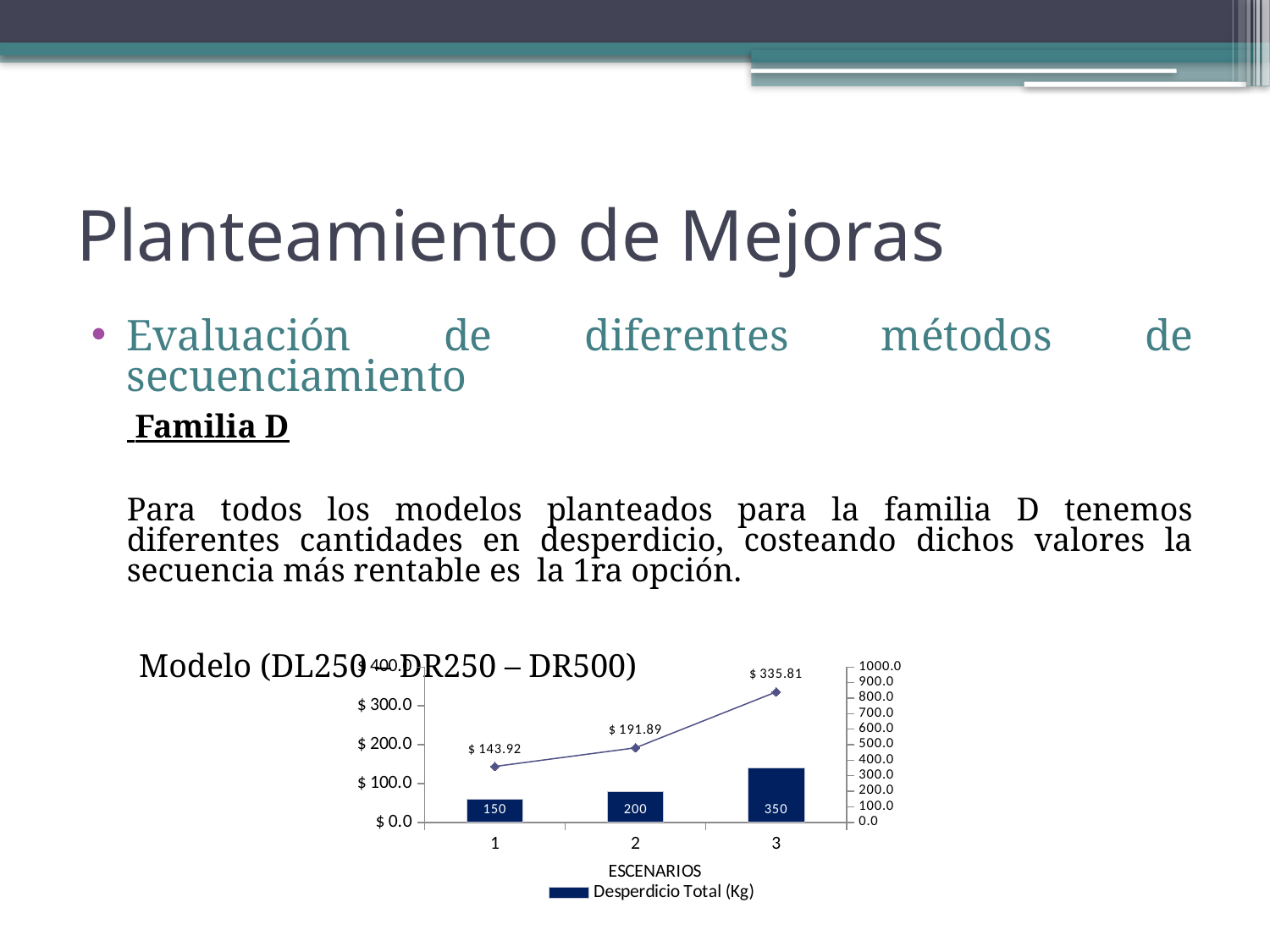
How many scenarios are plotted on the x axis? 3 What is the Desperdicio Total (Kg) value for scenario 1? 150 Which scenario has a larger Desperdicio Total (Kg), scenario 1 or scenario 2? 2 Do the line values rise or fall from scenario 1 to scenario 3? rise What series name is shown in the chart legend? Desperdicio Total (Kg) What is the title of the x axis of the chart? ESCENARIOS What is the cost value shown on the line for scenario 2? $ 191.89 Which scenario has the lowest cost value on the line? 1 What is the Desperdicio Total (Kg) value for scenario 3? 350 What is the difference in Desperdicio Total (Kg) between scenario 3 and scenario 2? 150 Which scenario has the highest Desperdicio Total (Kg)? 3 What is the cost value shown on the line for scenario 3? $ 335.81